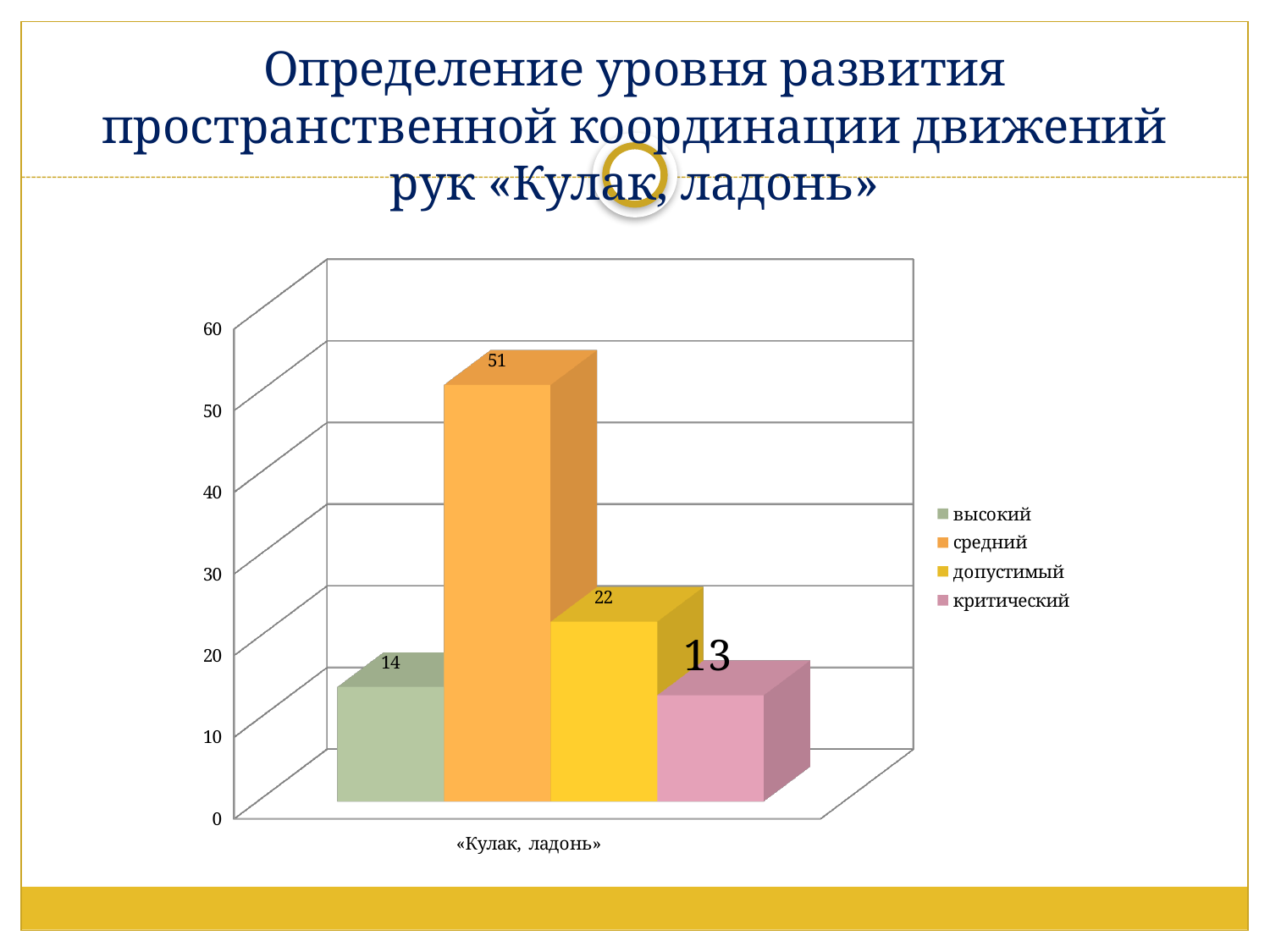
What is the difference between the values for «средний» and «допустимый»? 29 What is the value for the series «критический»? 13 How many series does the legend list? 4 What is the category label shown on the x axis? «Кулак, ладонь» What kind of chart is shown on the slide? bar chart What is the value for the series «высокий»? 14 Is the value for «средний» greater or less than 40? greater What is the value for the series «средний»? 51 Which is larger, the value for «высокий» or the value for «допустимый»? допустимый Which series has the highest value? средний What is the value for the series «допустимый»? 22 Which series has the lowest value? критический